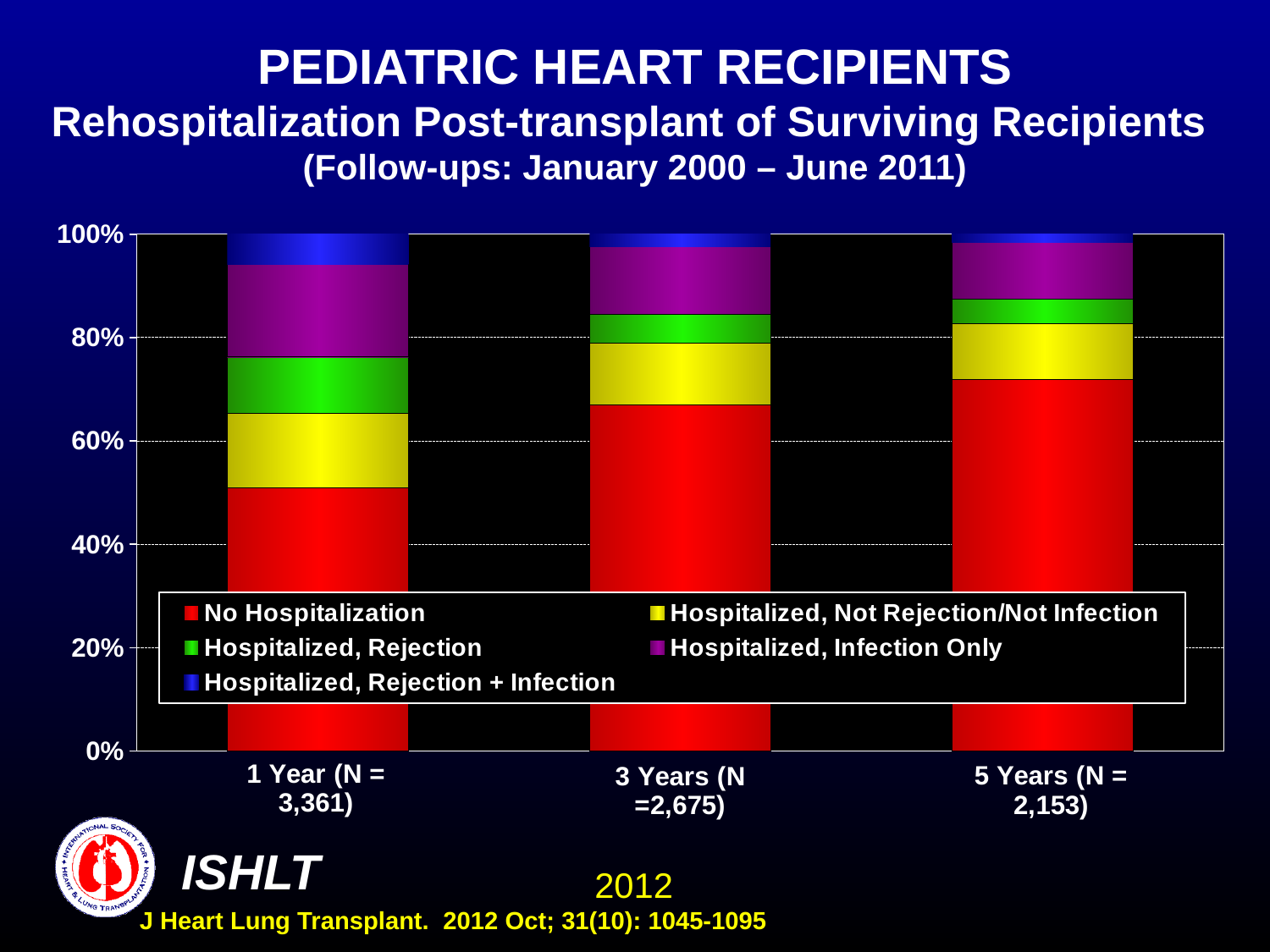
Is the value for No Hospitalization at 3 Years greater or less than 60%? greater How many time-point categories are shown on the x axis? 3 Does the share of No Hospitalization rise or fall from 1 Year to 5 Years? rises At which time point is the No Hospitalization share the smallest? 1 Year (N = 3,361) At which time point is the No Hospitalization share the largest? 5 Years (N = 2,153) Is the value for No Hospitalization at 5 Years greater or less than 60%? greater What is the N shown for the 3 Years category? 2,675 Is the value for No Hospitalization at 1 Year greater or less than 60%? less How many series does the legend list? 5 Is the No Hospitalization share larger at 1 Year or at 5 Years? 5 Years Which colour represents No Hospitalization in the legend? red What kind of chart is shown on the slide? stacked bar chart